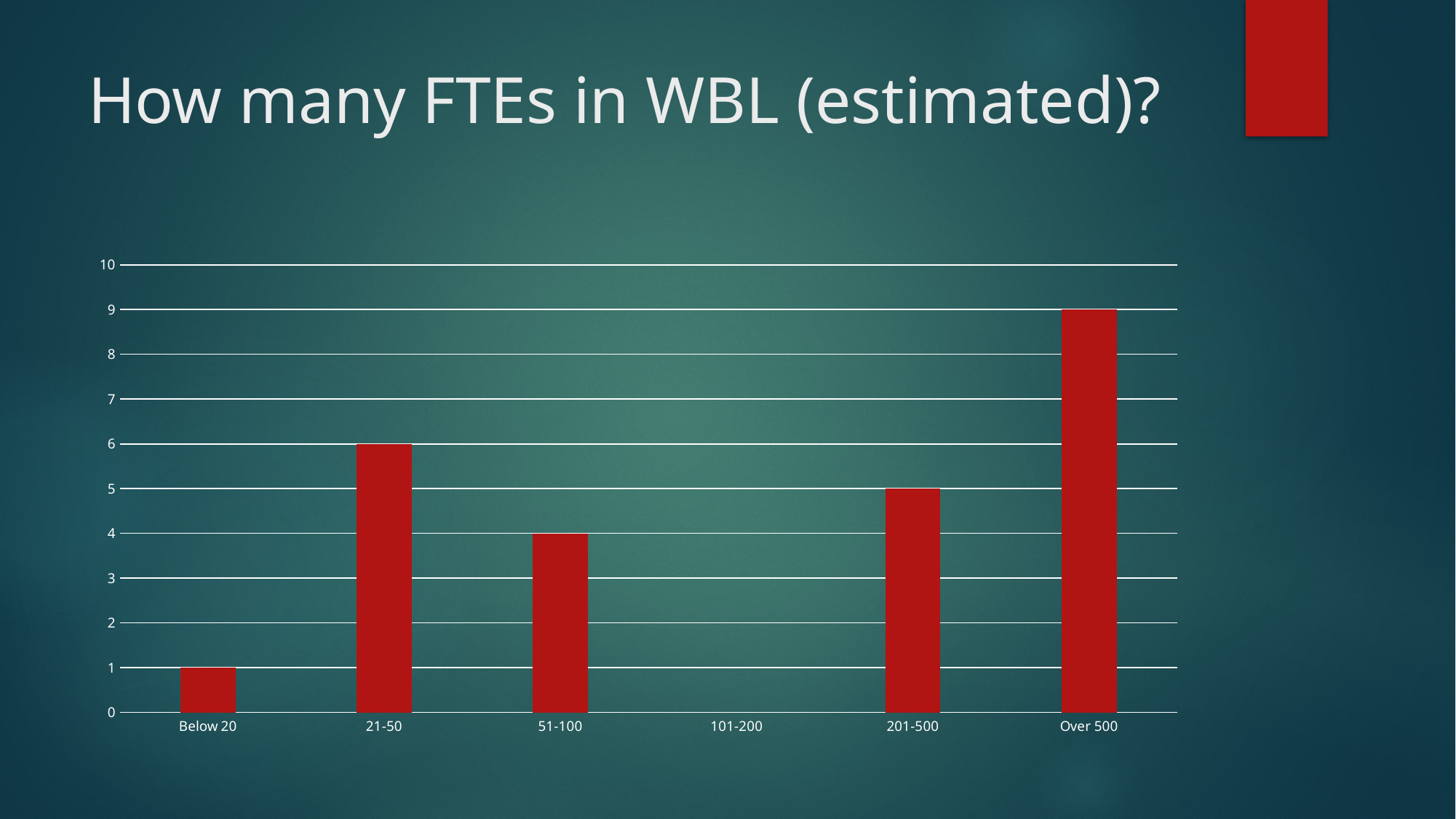
How many categories are shown on the x axis? 6 What is the value for the 21-50 category? 6 What is the value for the Below 20 category? 1 Which is larger, the value for 21-50 or the value for 51-100? 21-50 Is the value for 201-500 greater or less than 3? greater What is the value for the 51-100 category? 4 What is the difference between the values for Over 500 and 201-500? 4 What is the title of the slide? How many FTEs in WBL (estimated)? Which category has the lowest value? Below 20 What kind of chart is shown on the slide? Bar chart What is the value for the Over 500 category? 9 Which category has the highest value? Over 500